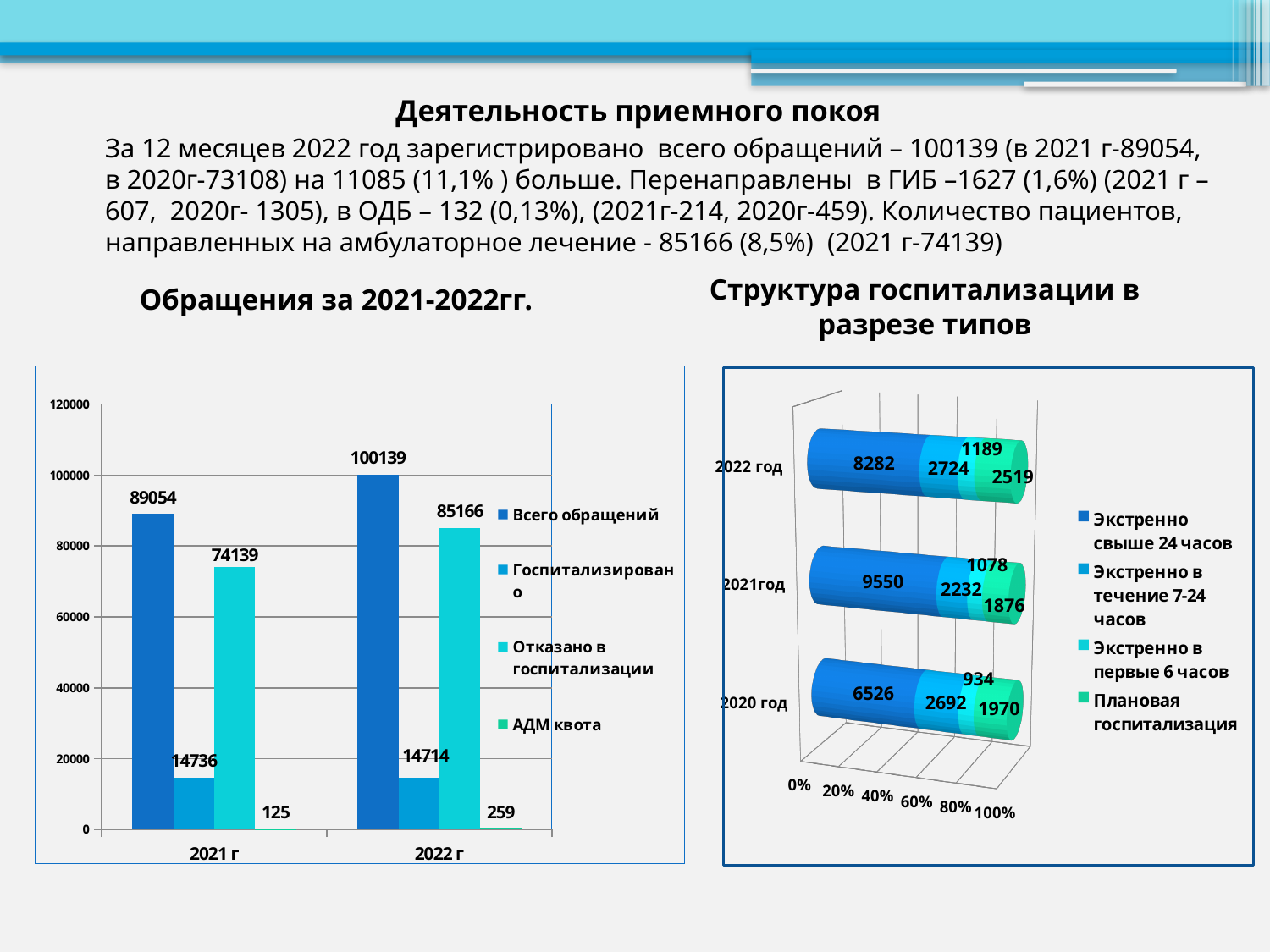
What kind of chart is 'Обращения за 2021-2022гг.'? bar chart In the chart 'Обращения за 2021-2022гг.', what is the value of 'Всего обращений' for 2022 г? 100139 In the chart 'Структура госпитализации в разрезе типов', what is the total of the 2022 год bar? 14714 In the chart 'Структура госпитализации в разрезе типов', what is the value of 'Плановая госпитализация' for 2020 год? 1970 In the chart 'Обращения за 2021-2022гг.', which is larger: 'Госпитализировано' in 2021 г or in 2022 г? 2021 г In the chart 'Структура госпитализации в разрезе типов', which year has the highest value for 'Экстренно свыше 24 часов'? 2021год In the chart 'Обращения за 2021-2022гг.', what is the difference between 'Всего обращений' in 2022 г and in 2021 г? 11085 In the chart 'Обращения за 2021-2022гг.', how many series does the legend list? 4 In the chart 'Структура госпитализации в разрезе типов', how many year categories are shown? 3 In the chart 'Обращения за 2021-2022гг.', what is the value of 'АДМ квота' for 2022 г? 259 In the chart 'Структура госпитализации в разрезе типов', what is the value of 'Экстренно свыше 24 часов' for 2021год? 9550 In the chart 'Обращения за 2021-2022гг.', what is the value of 'Отказано в госпитализации' for 2021 г? 74139